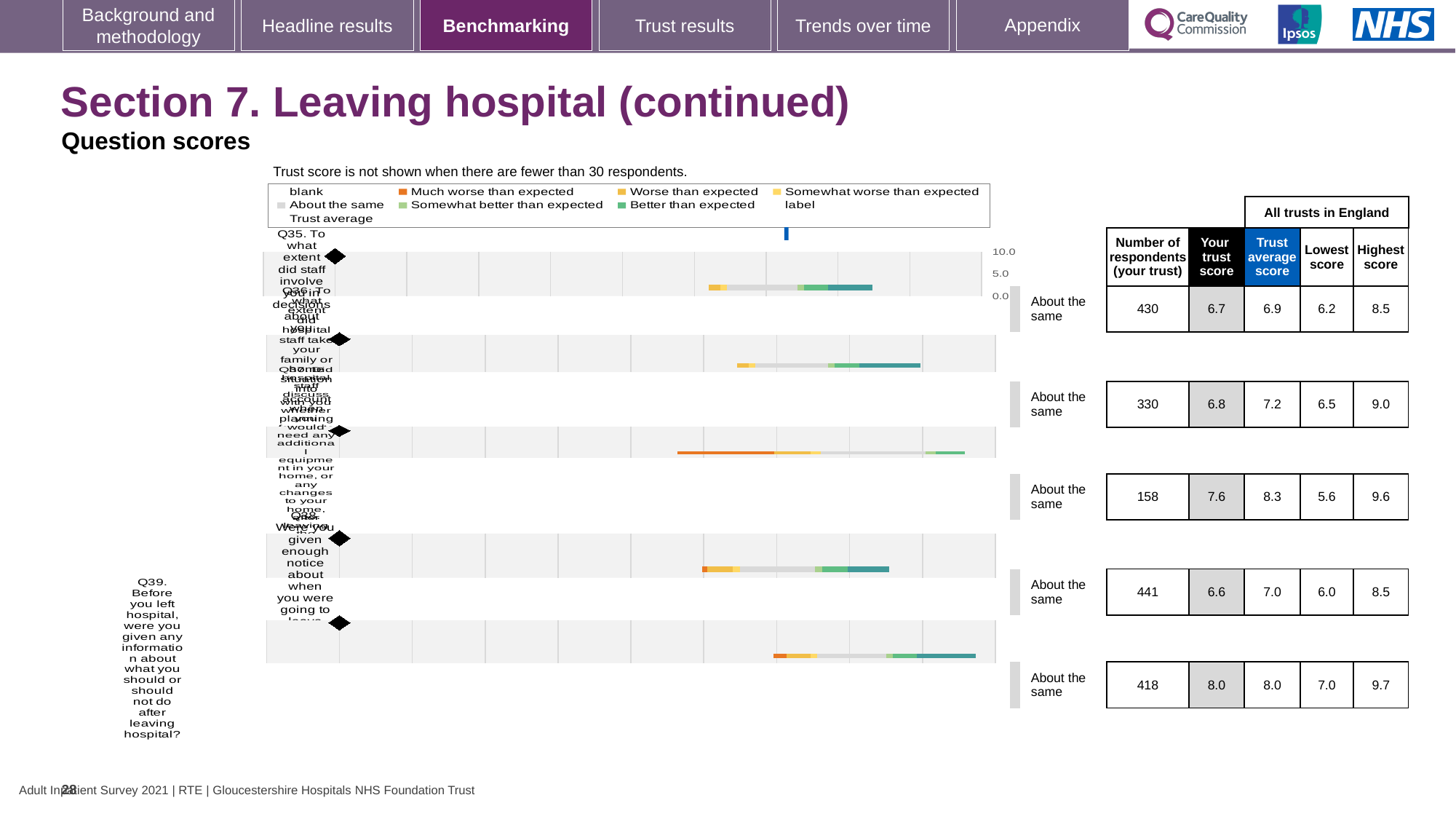
Which has the larger 'Your trust score': Q36 or Q38? Q36 How many questions are plotted on the chart? 5 For Q37, how much higher is the trust average score than your trust score? 0.7 For Q38, what is the difference between the highest score and the lowest score across all trusts in England? 2.5 How many respondents from your trust answered Q37 (additional equipment or changes to your home)? 158 Which question has the fewest respondents from your trust? Q37 What is the highest score across all trusts in England for Q39? 9.7 What benchmark category is shown next to each question on the chart? About the same Which question has the highest 'Your trust score'? Q39 What kind of chart is used to show the question scores? Bar chart What is the 'Your trust score' value for Q39 (information about what you should or should not do after leaving hospital)? 8.0 What is the trust average score for Q36 (staff taking your family or home situation into account)? 7.2